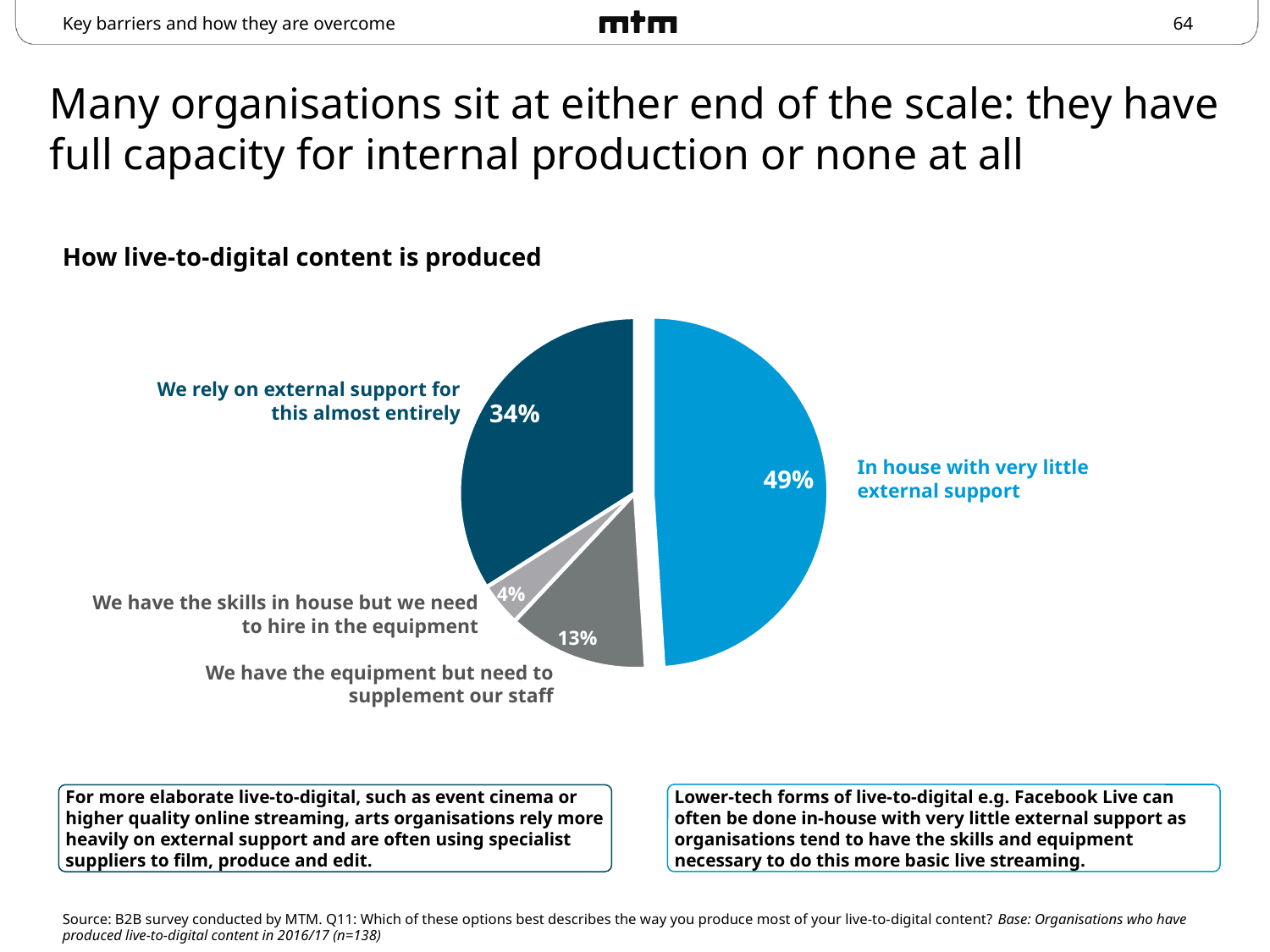
How many slices does the pie chart have? 4 What percentage of organisations have the skills in house but need to hire in the equipment? 4% What is the title of the chart? How live-to-digital content is produced Which category has the largest share of the pie? In house with very little external support What is the difference in percentage points between 'In house with very little external support' and 'We rely on external support for this almost entirely'? 15 percentage points What is the combined share of the two categories 'We have the equipment but need to supplement our staff' and 'We have the skills in house but we need to hire in the equipment'? 17% What kind of chart is shown on the slide? Pie chart What percentage of organisations have the equipment but need to supplement their staff? 13% Which category has the smallest share of the pie? We have the skills in house but we need to hire in the equipment What share of organisations produce live-to-digital content in house with very little external support? 49% What percentage of organisations rely on external support for this almost entirely? 34% Which is larger: the share for 'We have the equipment but need to supplement our staff' or the share for 'We have the skills in house but we need to hire in the equipment'? We have the equipment but need to supplement our staff